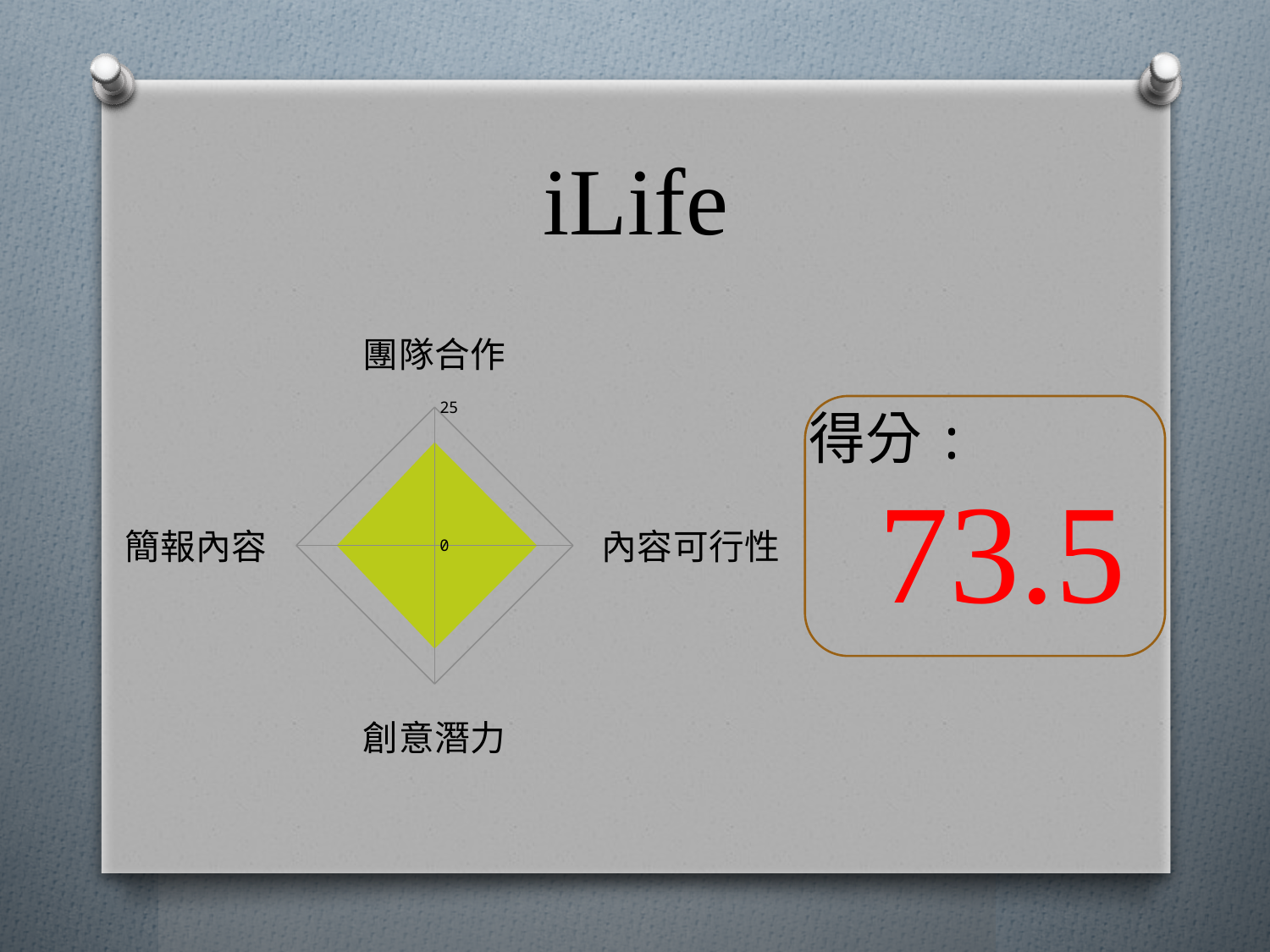
Is the value for 簡報內容 greater or less than 25? less Is the value for 內容可行性 greater or less than 25? less What is the maximum value shown on the radar chart's axis scale? 25 Is the value for 團隊合作 greater or less than 25? less What kind of chart is shown on the slide? radar chart How many categories (axes) does the radar chart have? 4 Which category label appears at the top of the radar chart? 團隊合作